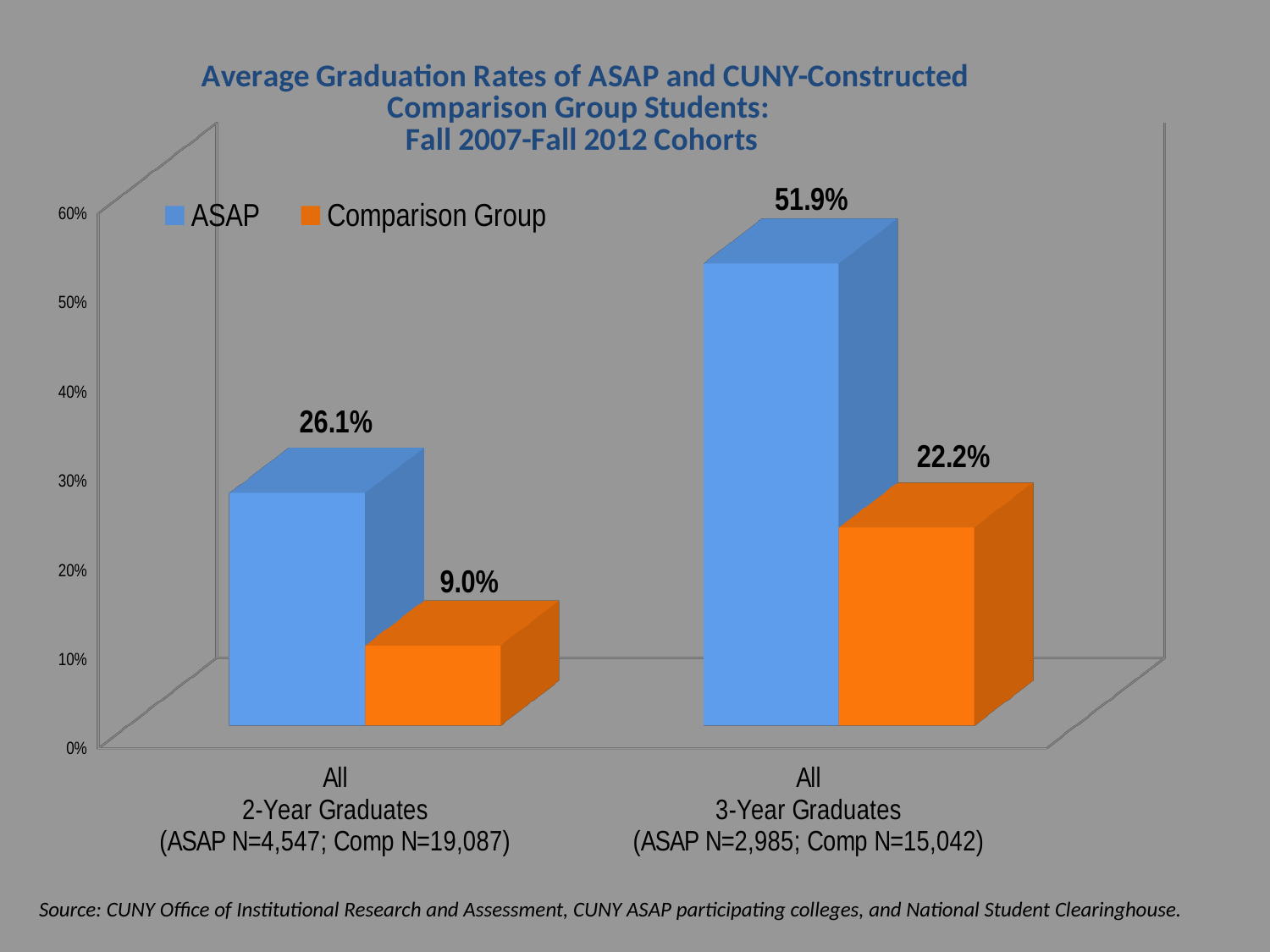
Is the ASAP rate for 3-Year Graduates greater or less than 50%? greater What is the Comparison Group graduation rate for 3-Year Graduates? 22.2% Which is larger: the ASAP rate for 2-Year Graduates or the Comparison Group rate for 3-Year Graduates? ASAP rate for 2-Year Graduates What is the difference between the ASAP and Comparison Group rates for 3-Year Graduates? 29.7 percentage points What kind of chart is shown on the slide? Bar chart What colour represents the Comparison Group in the chart? Orange What is the ASAP graduation rate for 2-Year Graduates? 26.1% Which bar shows the lowest graduation rate on the chart? Comparison Group, 2-Year Graduates (9.0%) What is the difference between the ASAP and Comparison Group rates for 2-Year Graduates? 17.1 percentage points How many series does the legend list? 2 What is the Comparison Group graduation rate for 2-Year Graduates? 9.0% Which bar shows the highest graduation rate on the chart? ASAP, 3-Year Graduates (51.9%)